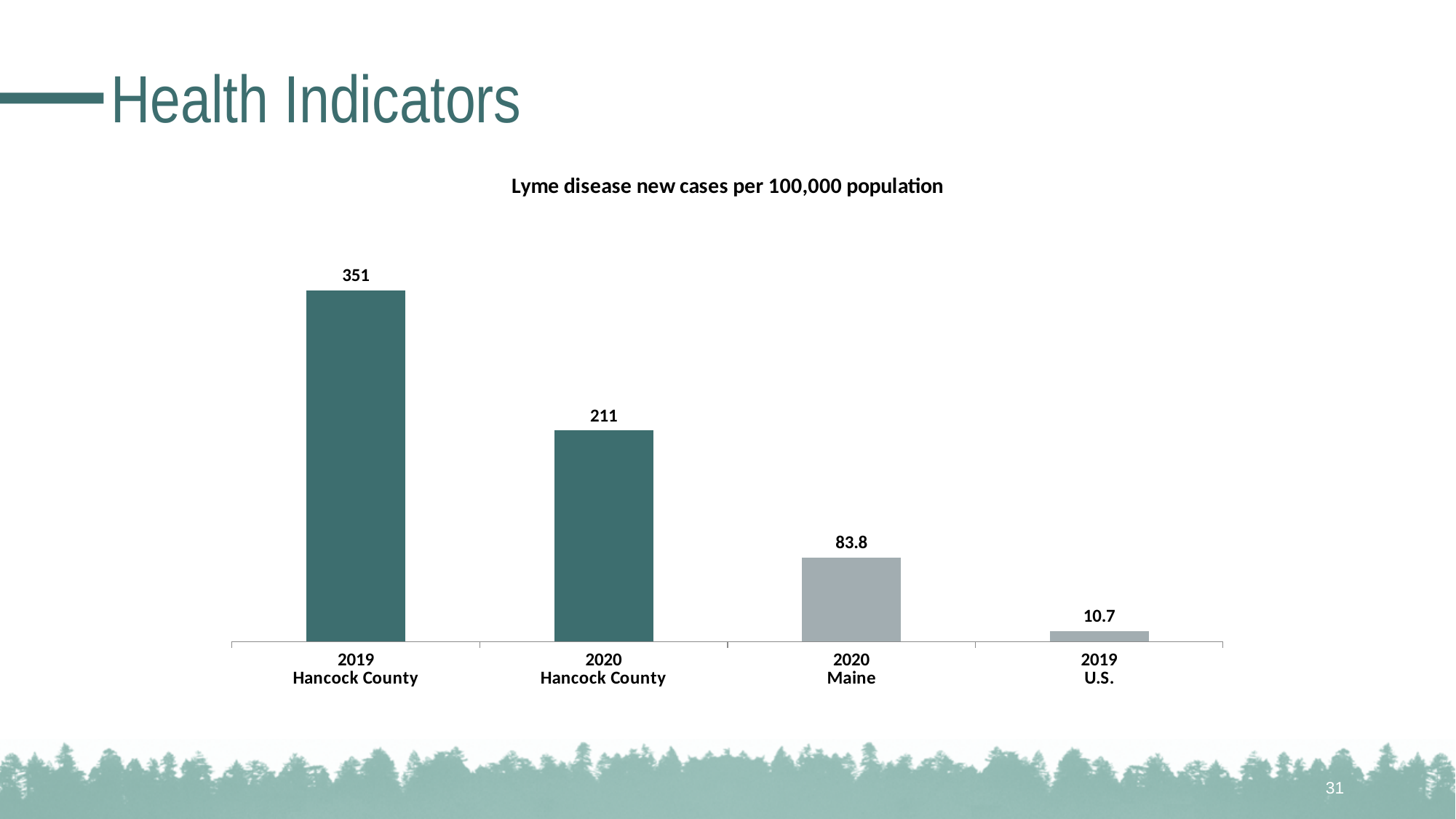
How many categories are shown in the chart? 4 Which category has the highest value? 2019 Hancock County What is the difference between the 2020 Maine and 2019 U.S. values? 73.1 What is the difference between the 2019 Hancock County and 2020 Hancock County values? 140 What is the value for 2019 Hancock County? 351 What kind of chart is shown on the slide? Bar chart What is the value for 2019 U.S.? 10.7 Which is larger, the value for 2020 Hancock County or the value for 2020 Maine? 2020 Hancock County What is the value for 2020 Hancock County? 211 Which category has the lowest value? 2019 U.S. What is the title of the chart? Lyme disease new cases per 100,000 population What is the value for 2020 Maine? 83.8